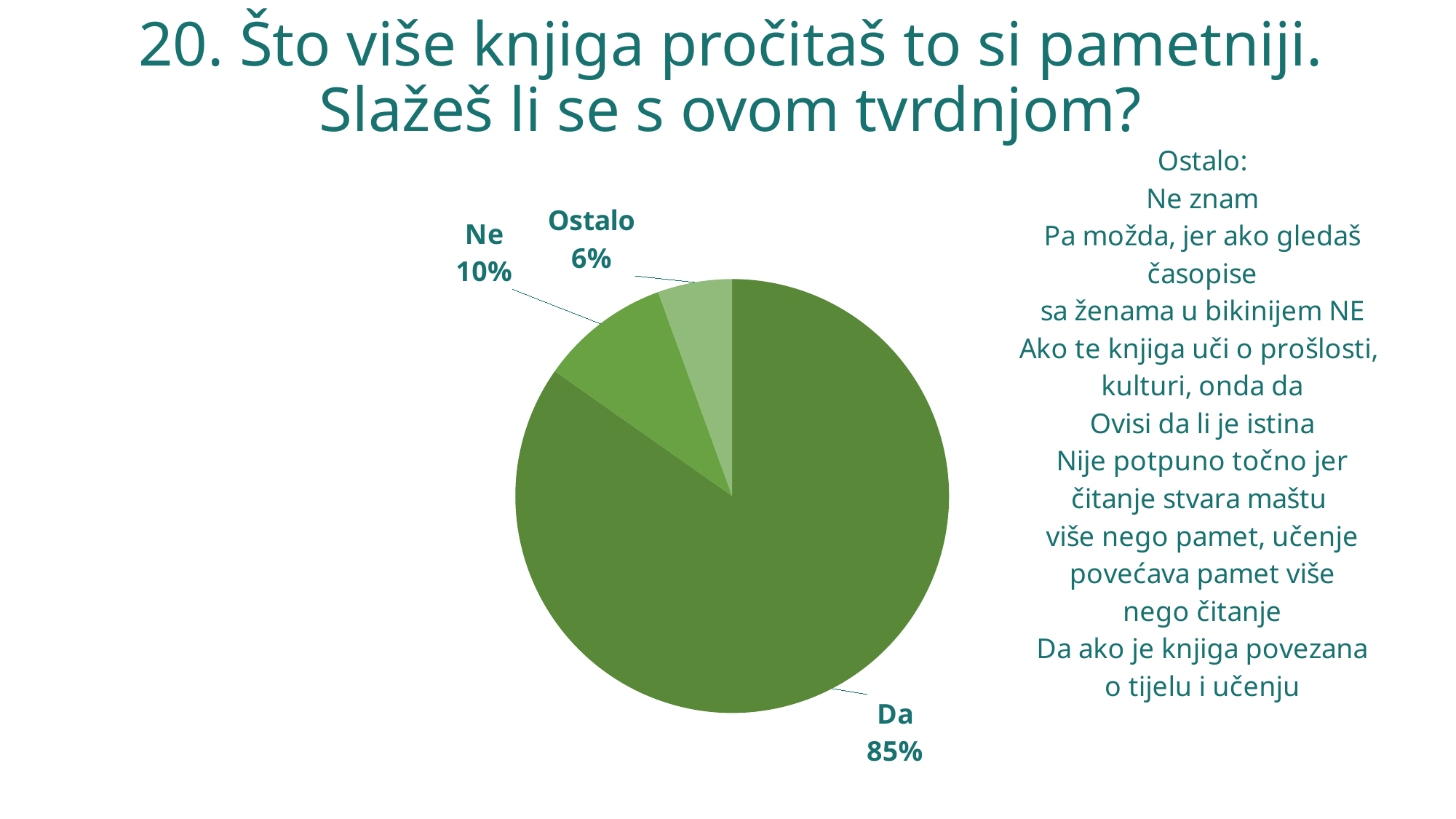
Which category has the smallest slice of the pie? Ostalo What share of the pie does the "Da" slice represent? 85% What is the difference in percentage points between the "Ne" and "Ostalo" slices? 4 Which slice is larger, "Da" or "Ne"? Da Which slice is larger, "Ne" or "Ostalo"? Ne What share of the pie does the "Ne" slice represent? 10% How many slices does the pie chart have? 3 Which slice of the pie is shown in the lightest shade of green? Ostalo What kind of chart is shown on the slide? pie chart What share of the pie does the "Ostalo" slice represent? 6% Which category has the largest slice of the pie? Da What is the difference in percentage points between the "Da" and "Ne" slices? 75